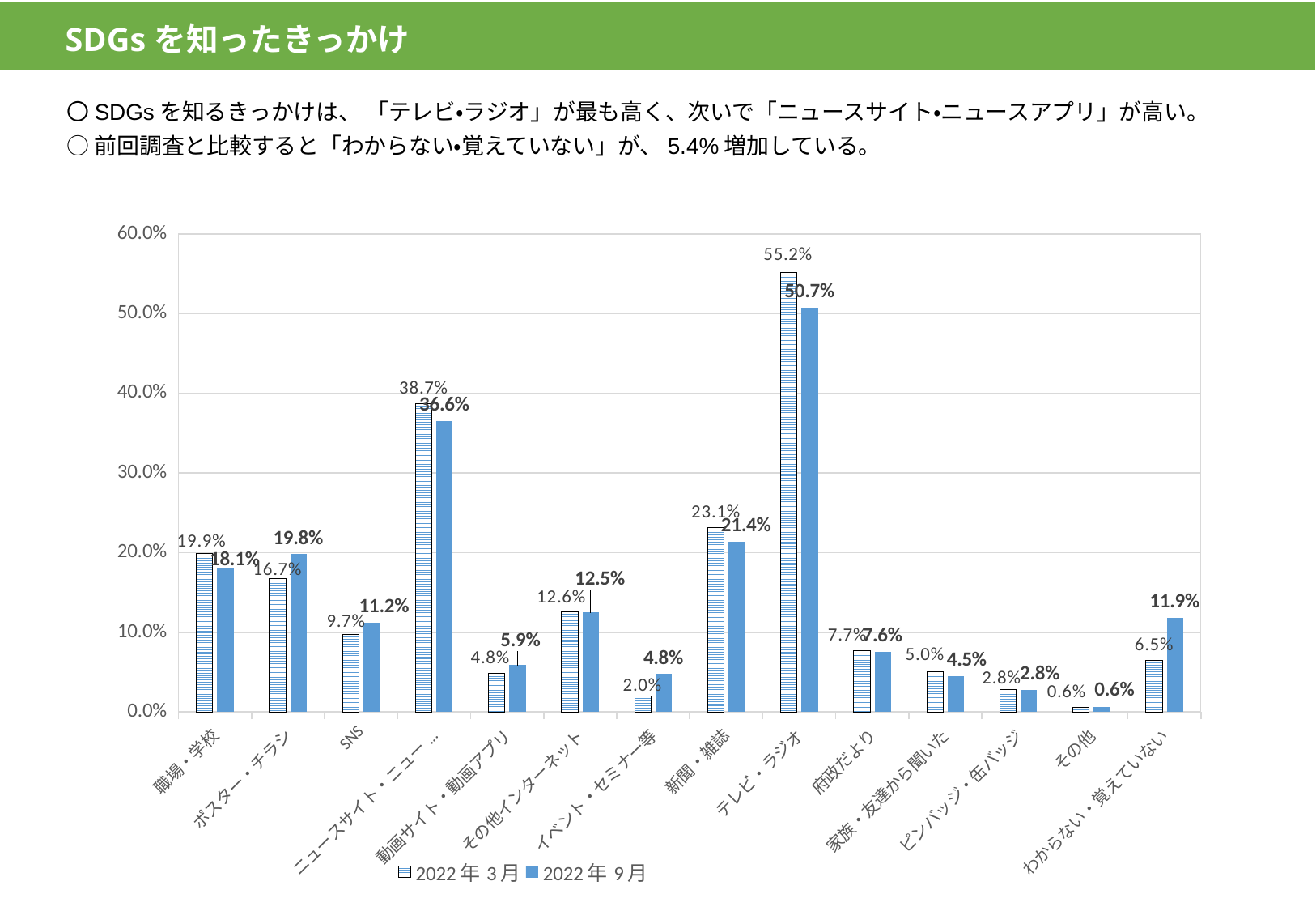
What is the difference between the 2022年3月 and 2022年9月 values for わからない・覚えていない? 5.4% For ポスター・チラシ, which series has the larger value, 2022年3月 or 2022年9月? 2022年9月 How many categories are shown on the x axis? 14 Which category has the highest value in the 2022年3月 series? テレビ・ラジオ What is the value for SNS in the 2022年9月 series? 11.2% How many series does the legend list? 2 What is the difference between the 2022年3月 and 2022年9月 values for テレビ・ラジオ? 4.5% What kind of chart is shown on the slide? Bar chart Which category has the lowest value in the 2022年9月 series? その他 What is the value for わからない・覚えていない in the 2022年3月 series? 6.5% What is the value for テレビ・ラジオ in the 2022年9月 series? 50.7% Is the 2022年3月 value for 新聞・雑誌 greater or less than 20.0%? greater